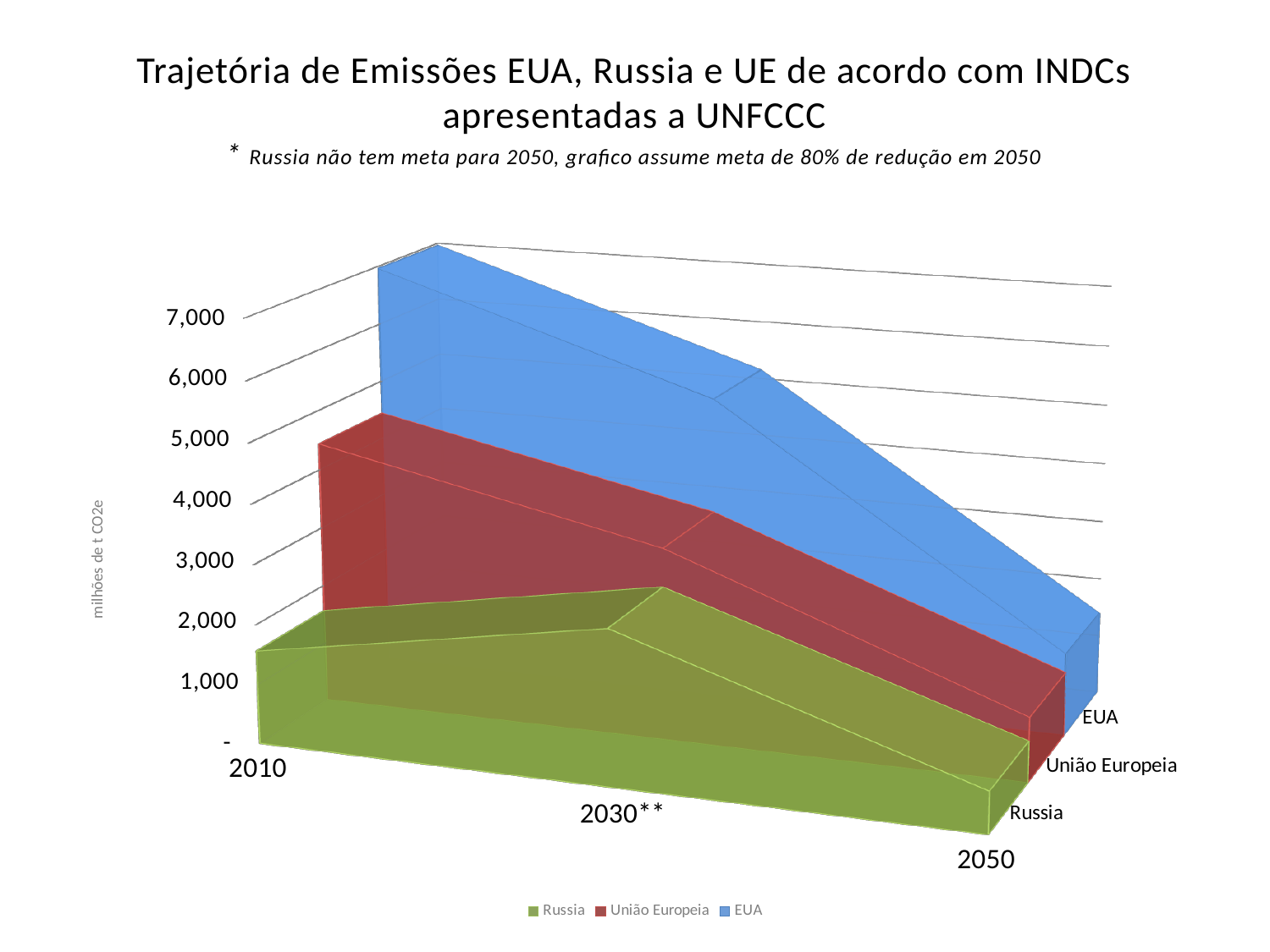
How many series does the legend list? 3 In 2010, which is larger: the value for EUA or the value for Russia? EUA Do the emissions for União Europeia rise or fall from 2010 to 2050? fall Is the value for Russia in 2010 greater or less than 3,000? less Is the value for EUA in 2050 greater or less than 3,000? less What unit is given on the vertical axis label? milhões de t CO2e Do the emissions for EUA rise or fall from 2010 to 2050? fall Which colour represents Russia in the legend? green Which series has the highest emissions in 2010? EUA How many years are shown along the x axis? 3 What kind of chart is shown on the slide? area chart Which series has the lowest emissions in 2010? Russia